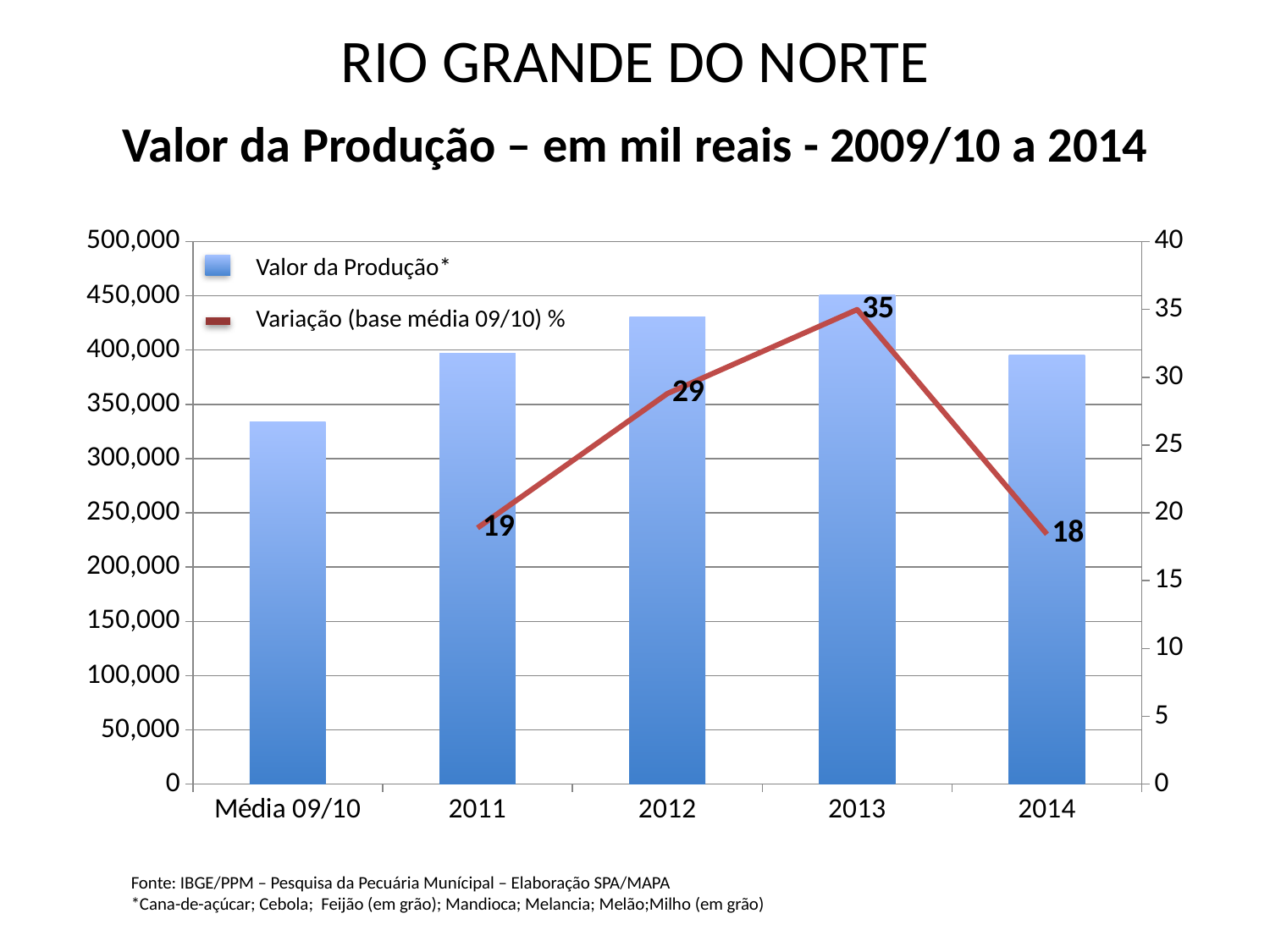
What is the value of Variação (base média 09/10) % for 2011? 19 In which year is the Variação (base média 09/10) % lowest? 2014 How many series does the legend list? 2 Is the Valor da Produção for 2012 greater or less than 400,000? greater What is the value of Variação (base média 09/10) % for 2014? 18 What is the value of Variação (base média 09/10) % for 2013? 35 Which has a larger Valor da Produção bar, 2013 or Média 09/10? 2013 What is the difference between the Variação values for 2013 and 2012? 6 In which year is the Variação (base média 09/10) % highest? 2013 How many categories are shown on the x axis? 5 What kind of chart is shown on the slide? Combined bar and line chart Is the Valor da Produção for Média 09/10 greater or less than 350,000? less